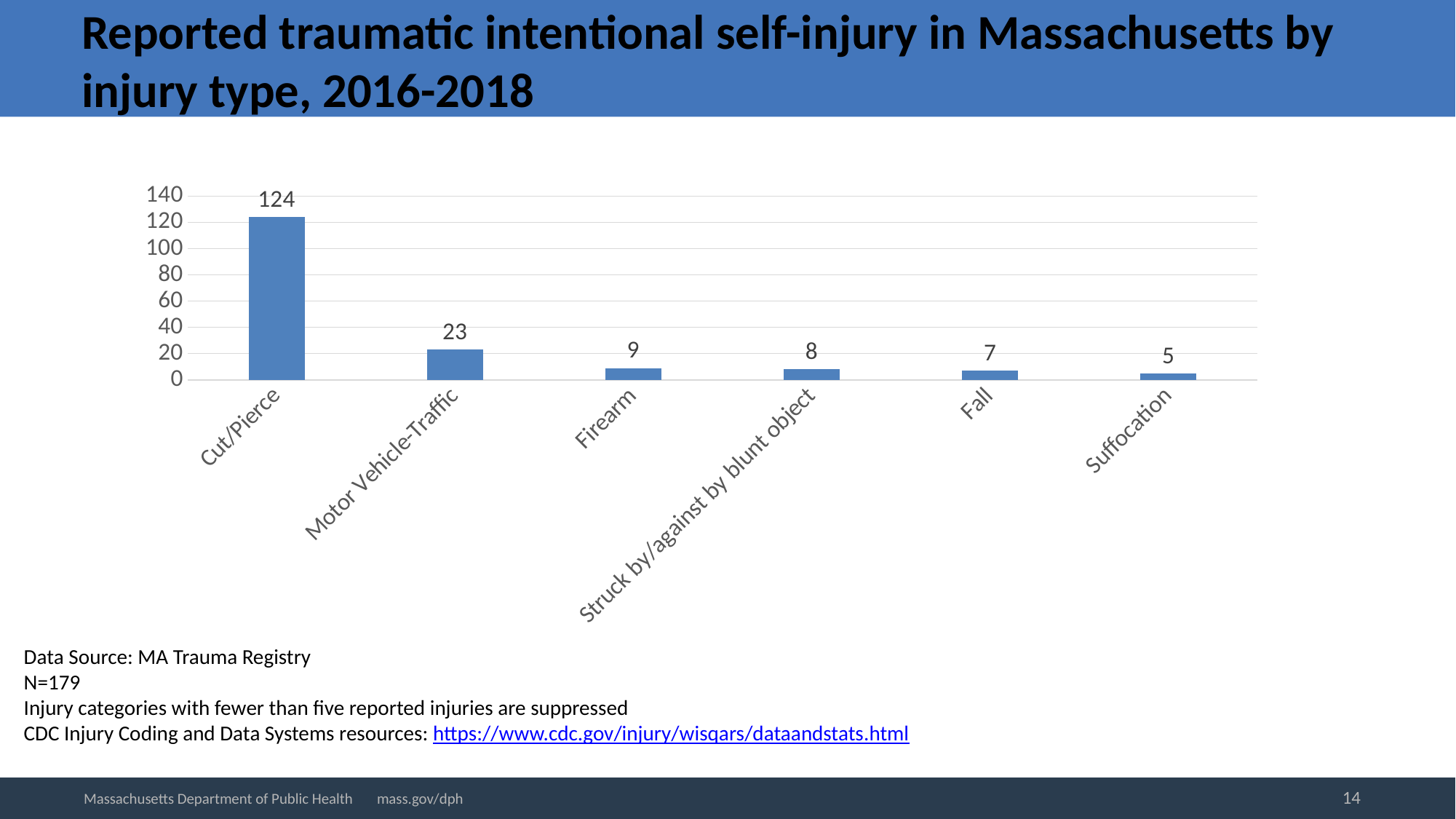
How many injury type categories are shown on the chart? 6 What kind of chart is shown on the slide? Bar chart Which injury type has the highest value? Cut/Pierce What is the value for Firearm? 9 What is the value for Suffocation? 5 What is the difference between the values for Cut/Pierce and Motor Vehicle-Traffic? 101 Which is larger, the value for Fall or the value for Motor Vehicle-Traffic? Motor Vehicle-Traffic Which injury type has the lowest value? Suffocation Is the value for Cut/Pierce greater or less than 100? greater What is the value for Cut/Pierce? 124 What is the value for Motor Vehicle-Traffic? 23 What is the value for Struck by/against by blunt object? 8